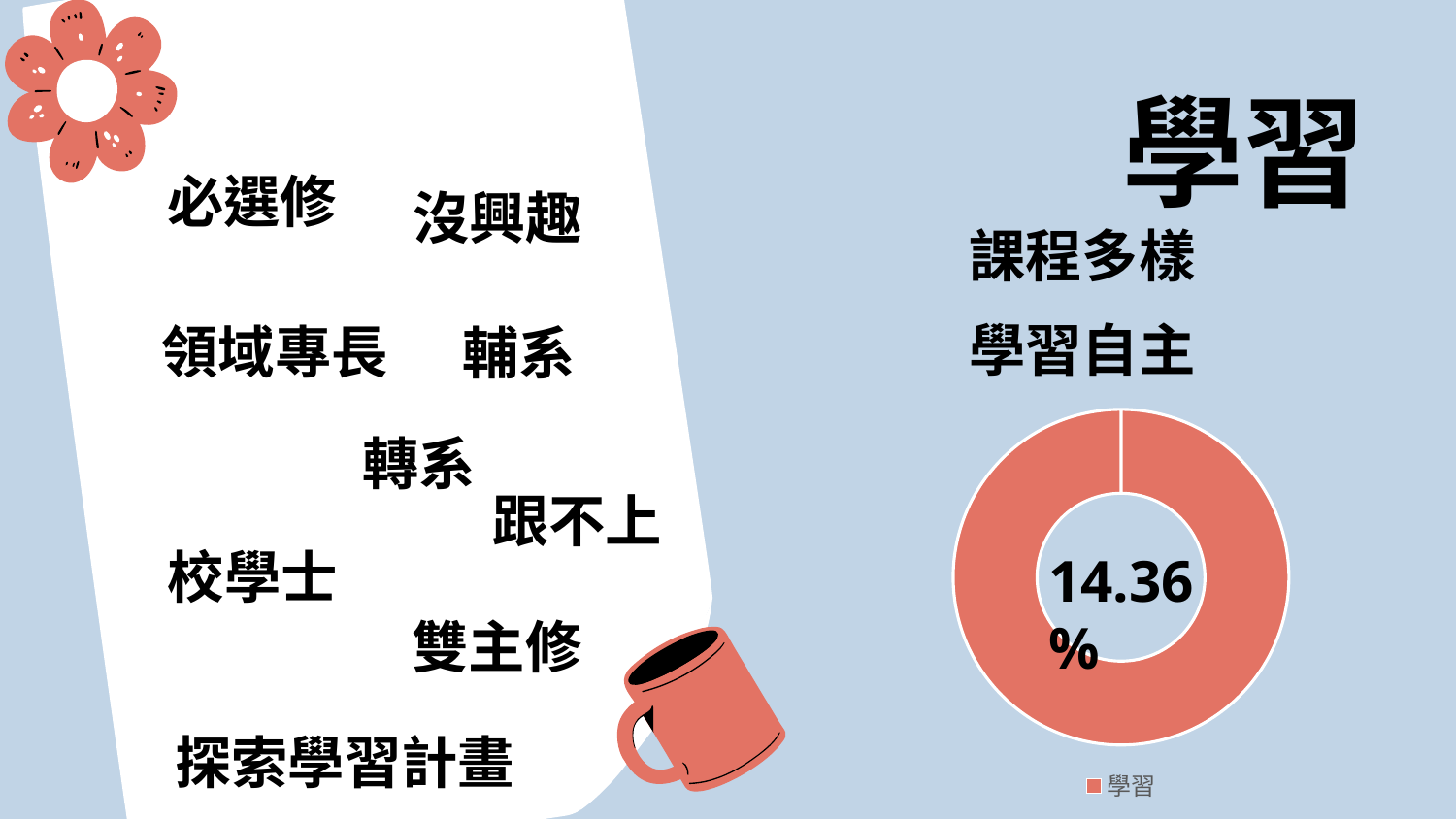
What kind of chart is shown on the right side of the slide? doughnut chart How many series does the legend of the doughnut chart list? 1 What colour is the ring of the doughnut chart? salmon red What is the value shown for 學習 in the doughnut chart? 14.36% Is the value shown in the doughnut chart greater or less than 50%? less Is the value shown in the doughnut chart greater or less than 10%? greater What value is printed in the centre of the doughnut chart? 14.36% What is the legend entry shown below the doughnut chart? 學習